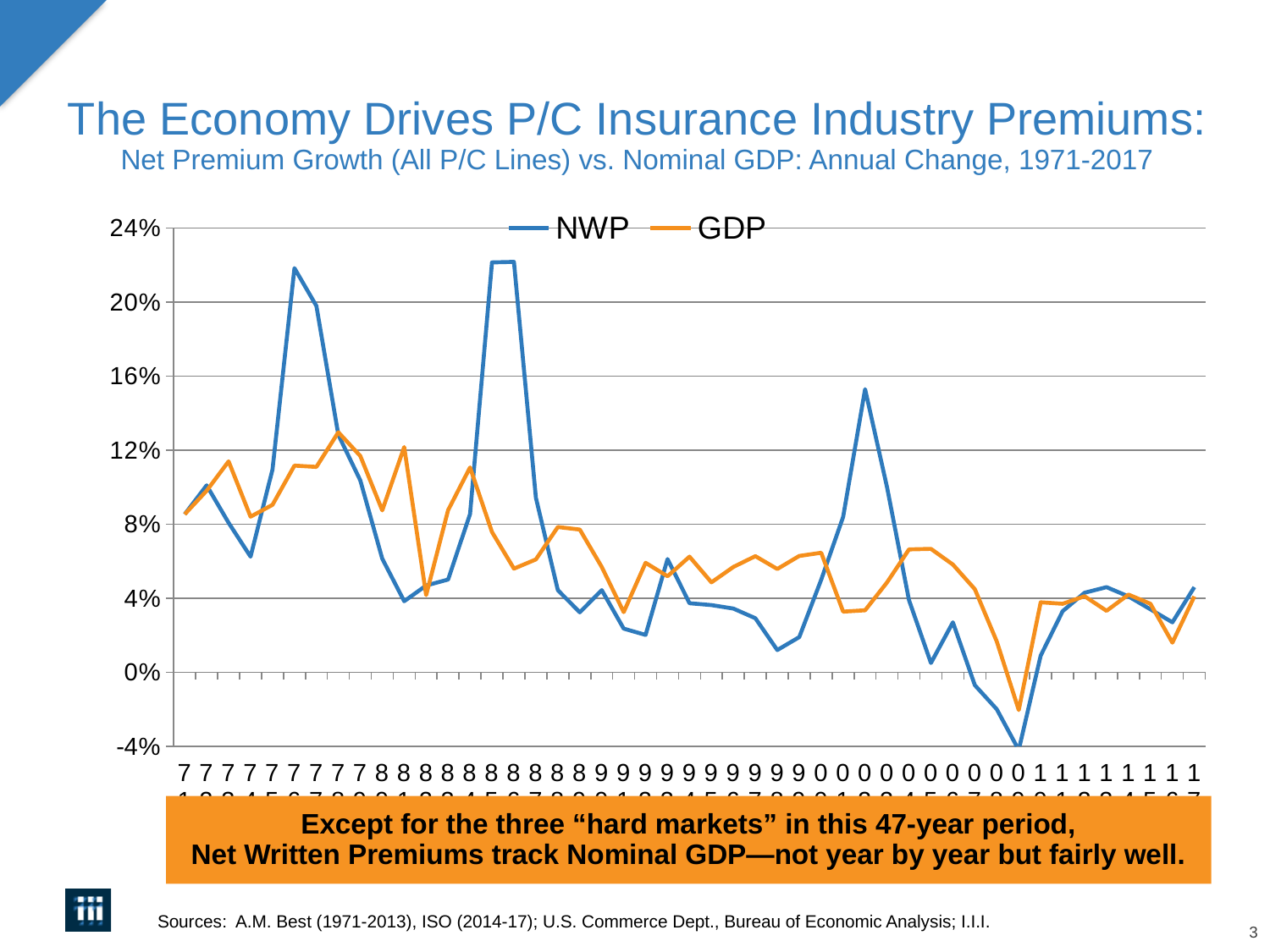
Is the lowest point of the NWP line greater or less than 0%? less Is the highest peak of the NWP line greater or less than 20%? greater Is the lowest point of the GDP line greater or less than 0%? less Which series reaches the lowest value anywhere on the chart? NWP Which series has the higher peak value, NWP or GDP? NWP Which colour is used for the GDP line? Orange Over the whole period shown, do the values of both lines generally rise or fall from left to right? fall Which series reaches the highest value anywhere on the chart? NWP What are the two series named in the legend? NWP and GDP How many series does the legend list? 2 What kind of chart is shown on the slide? Line chart